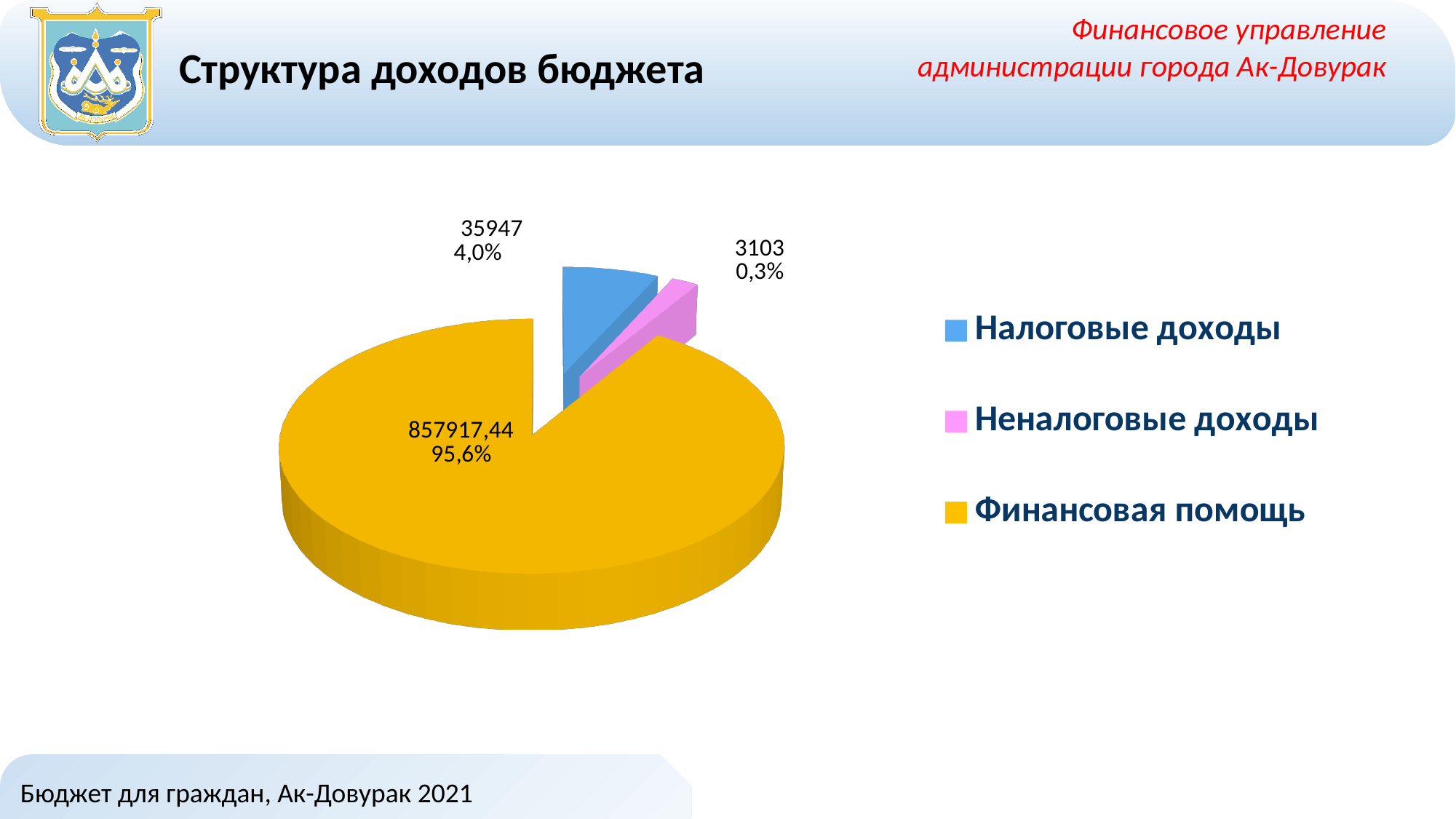
How many categories does the legend list? 3 What is the value for Неналоговые доходы? 3103 Which category has the largest slice? Финансовая помощь What is the value for Налоговые доходы? 35947 What is the difference between the values for Налоговые доходы and Неналоговые доходы? 32844 What kind of chart is shown on the slide? pie chart What share of the pie does Налоговые доходы take? 4,0% Which category has the smallest slice? Неналоговые доходы What is the value for Финансовая помощь? 857917,44 What share of the pie does Неналоговые доходы take? 0,3% What share of the pie does Финансовая помощь take? 95,6% Which is larger, Налоговые доходы or Неналоговые доходы? Налоговые доходы